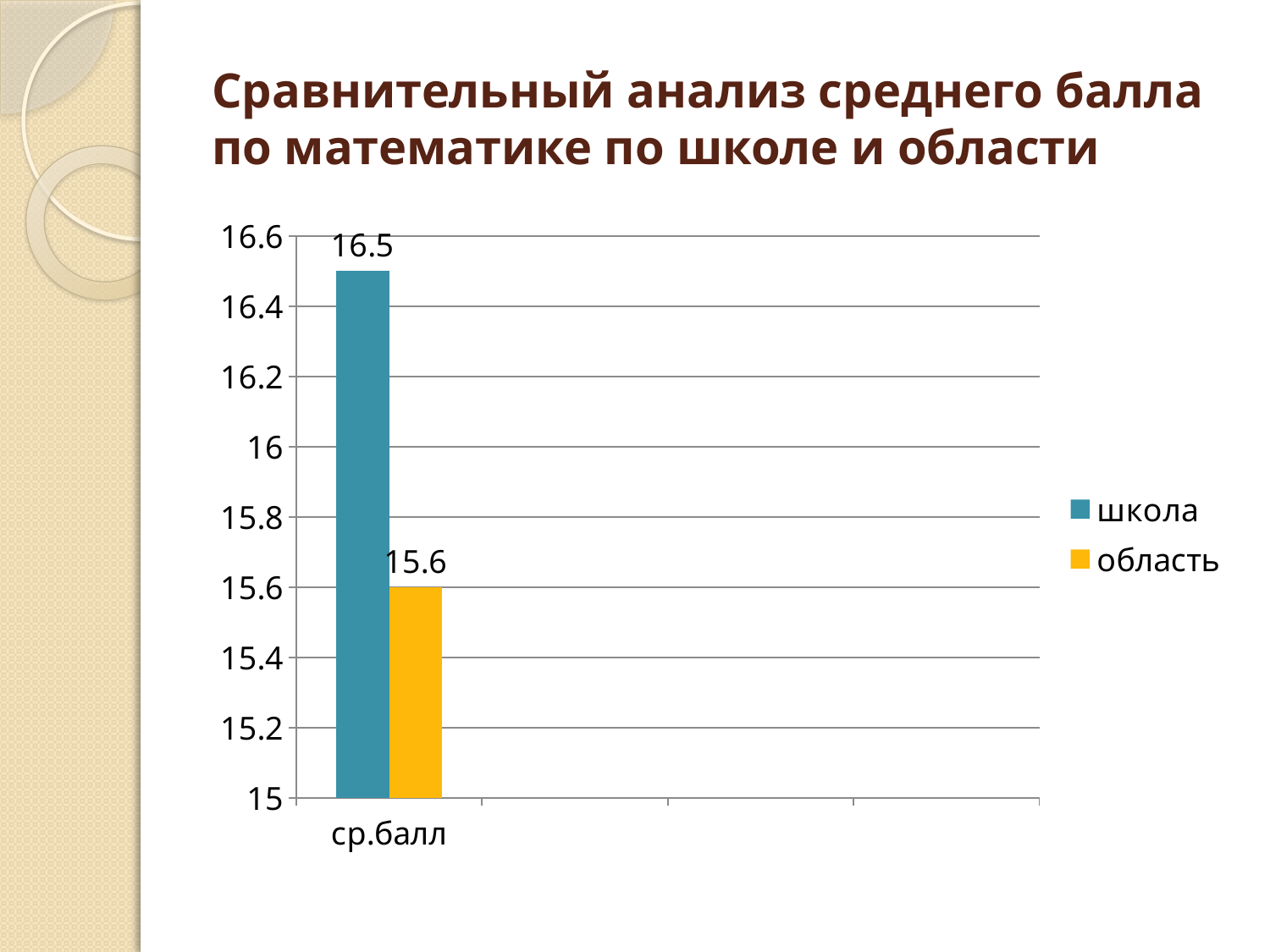
What is the difference between the школа value and the область value? 0.9 What is the label of the category on the x axis? ср.балл How many categories are shown on the x axis? 1 Which series has the lowest value? область What kind of chart is shown on the slide? bar chart What is the value for школа in the ср.балл category? 16.5 How many series does the legend list? 2 Is the value for область greater or less than 16? less Which series has the higher value: школа or область? школа What is the value for область in the ср.балл category? 15.6 Is the value for школа greater or less than 16.4? greater Which series is shown in yellow? область